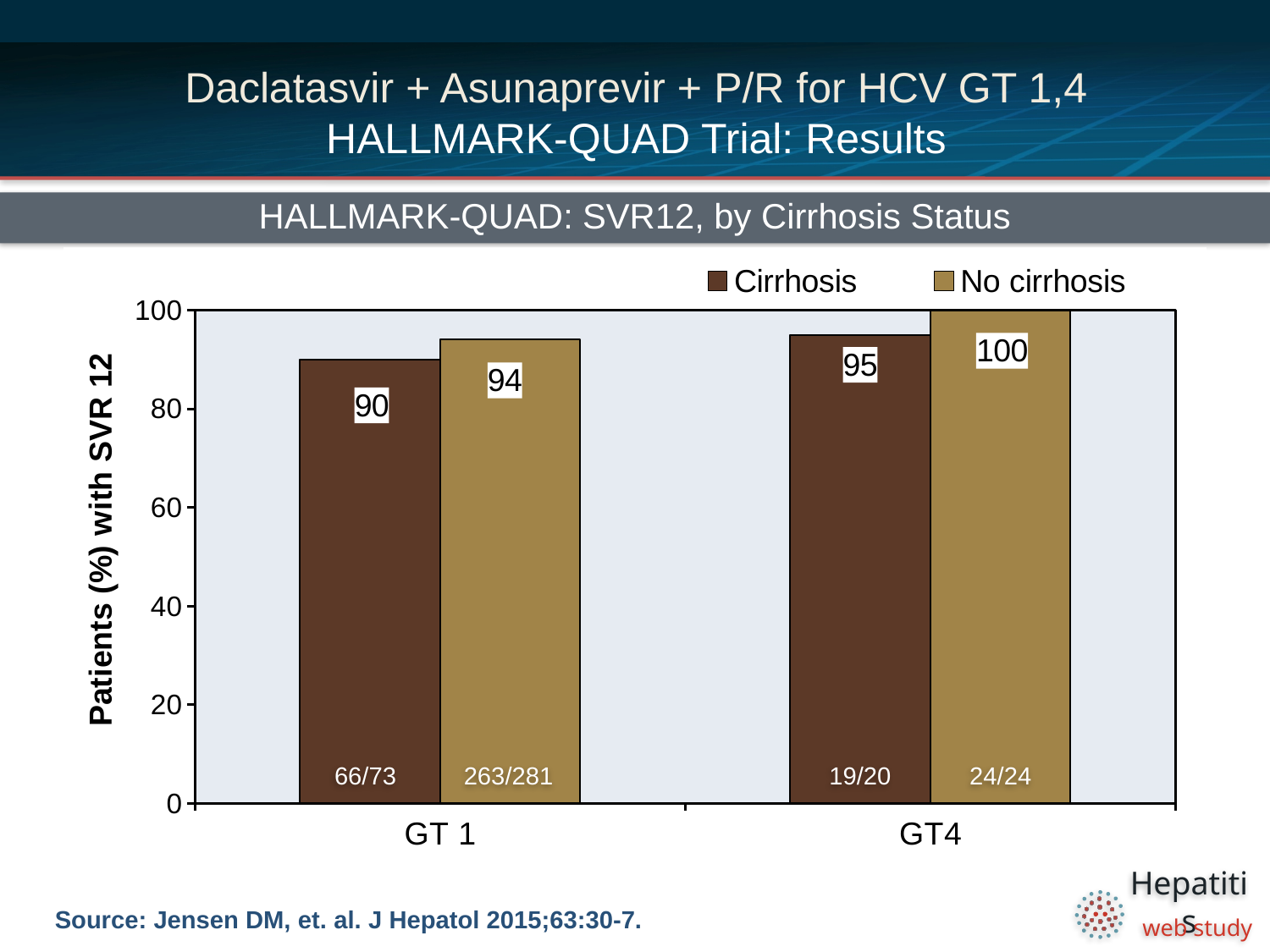
What is the SVR12 rate for patients with cirrhosis in the GT 1 group? 90 How many genotype groups are shown on the x axis? 2 Which bar shows the lowest SVR12 rate? Cirrhosis, GT 1 Which bar shows the highest SVR12 rate? No cirrhosis, GT4 What is the SVR12 rate for patients with no cirrhosis in the GT4 group? 100 Which is larger: the SVR12 rate for cirrhosis patients in GT4 or for no cirrhosis patients in GT 1? Cirrhosis patients in GT4 What is the SVR12 rate for patients with cirrhosis in the GT4 group? 95 What is the difference in SVR12 rate between no cirrhosis and cirrhosis patients in the GT4 group? 5 How many series does the legend list? 2 What is the SVR12 rate for patients with no cirrhosis in the GT 1 group? 94 What is the difference in SVR12 rate between no cirrhosis and cirrhosis patients in the GT 1 group? 4 What kind of chart is shown on the slide? Bar chart